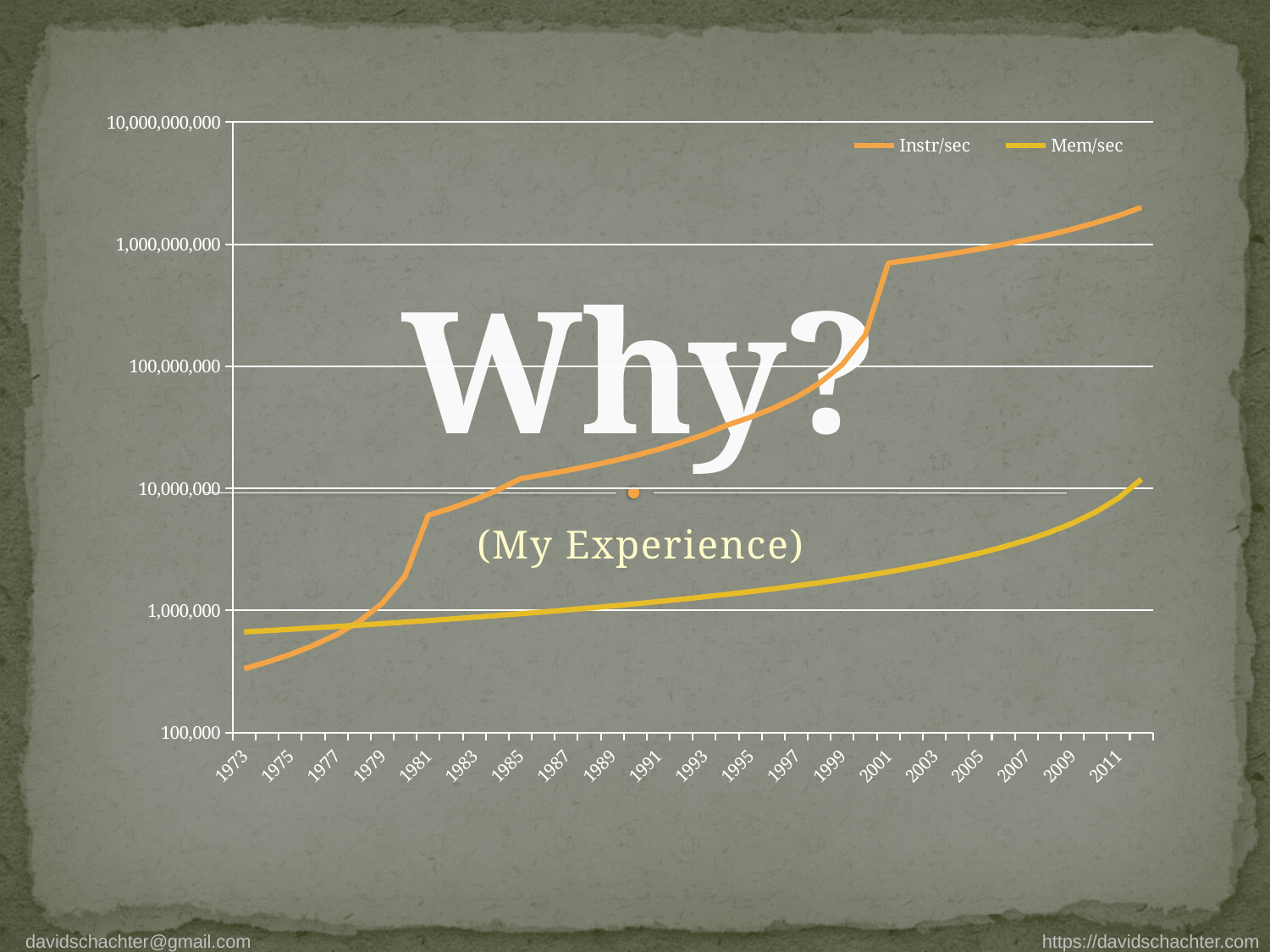
What are the two series named in the legend? Instr/sec and Mem/sec Is the Mem/sec value for 2001 greater or less than 1,000,000? greater What kind of chart is shown on the slide? line chart In 2011, which series has the higher value, Instr/sec or Mem/sec? Instr/sec Does the Instr/sec series rise or fall from 1973 to 2011? rise In 1973, which series has the higher value, Instr/sec or Mem/sec? Mem/sec How many year labels are shown on the x axis? 20 Does the Mem/sec series rise or fall from 1973 to 2011? rise What is the large title text overlaid on the chart? Why? Is the Instr/sec value for 1973 greater or less than 1,000,000? less How many series does the legend list? 2 Is the Instr/sec value for 2011 greater or less than 1,000,000,000? greater